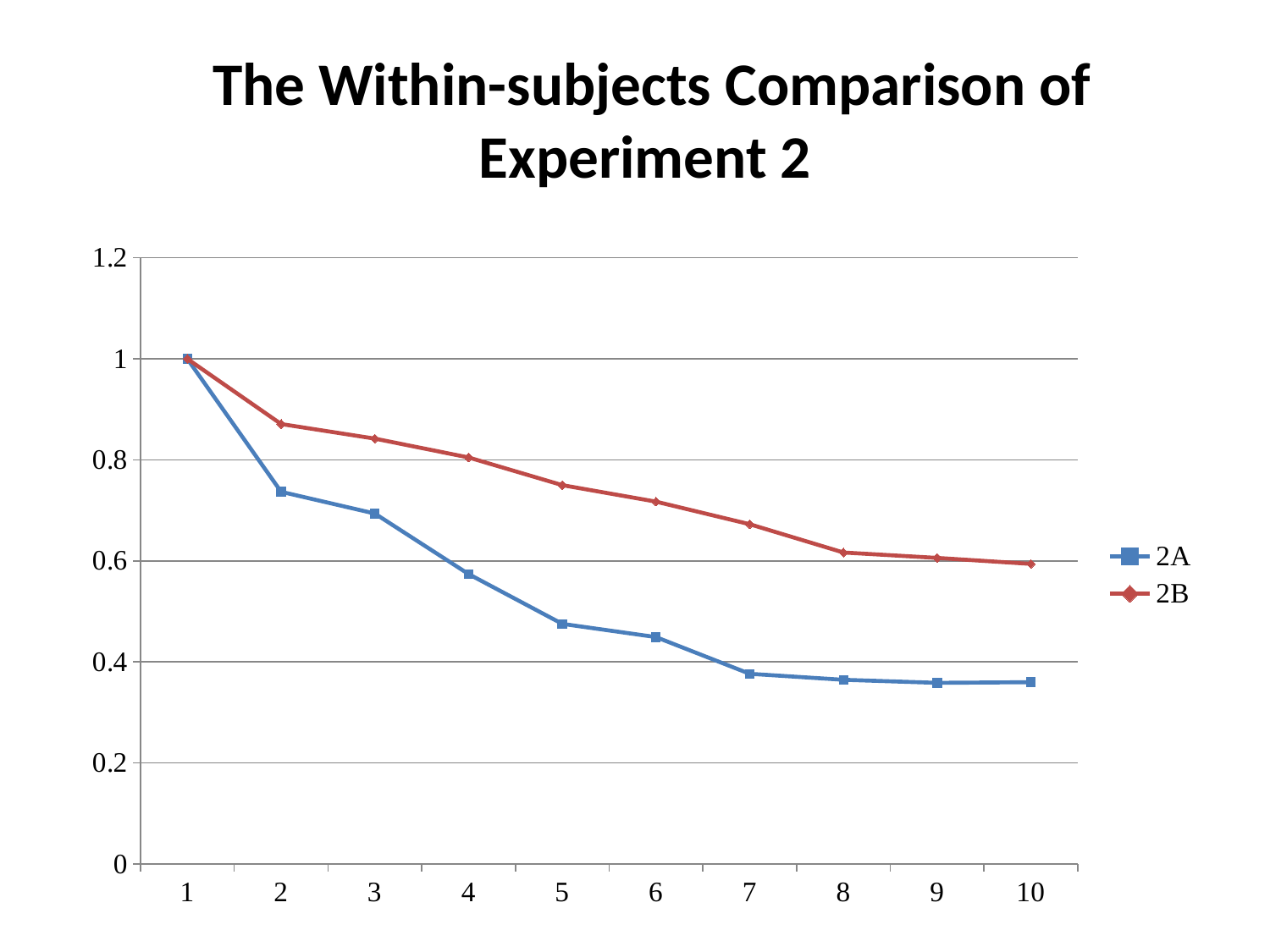
How many points are plotted along the x axis for each series? 10 How many series does the legend list? 2 What is the title of the chart? The Within-subjects Comparison of Experiment 2 At which x value does series 2A reach its highest value? 1 What is the value of series 2A at x = 1? 1 Is the value for series 2A at x = 10 greater or less than 0.4? less What kind of chart is shown on the slide? line chart Do the values of series 2A rise or fall as x increases from 1 to 10? fall Do the values of series 2B rise or fall as x increases from 1 to 10? fall At x = 5, which series has the larger value, 2A or 2B? 2B What is the value of series 2B at x = 1? 1